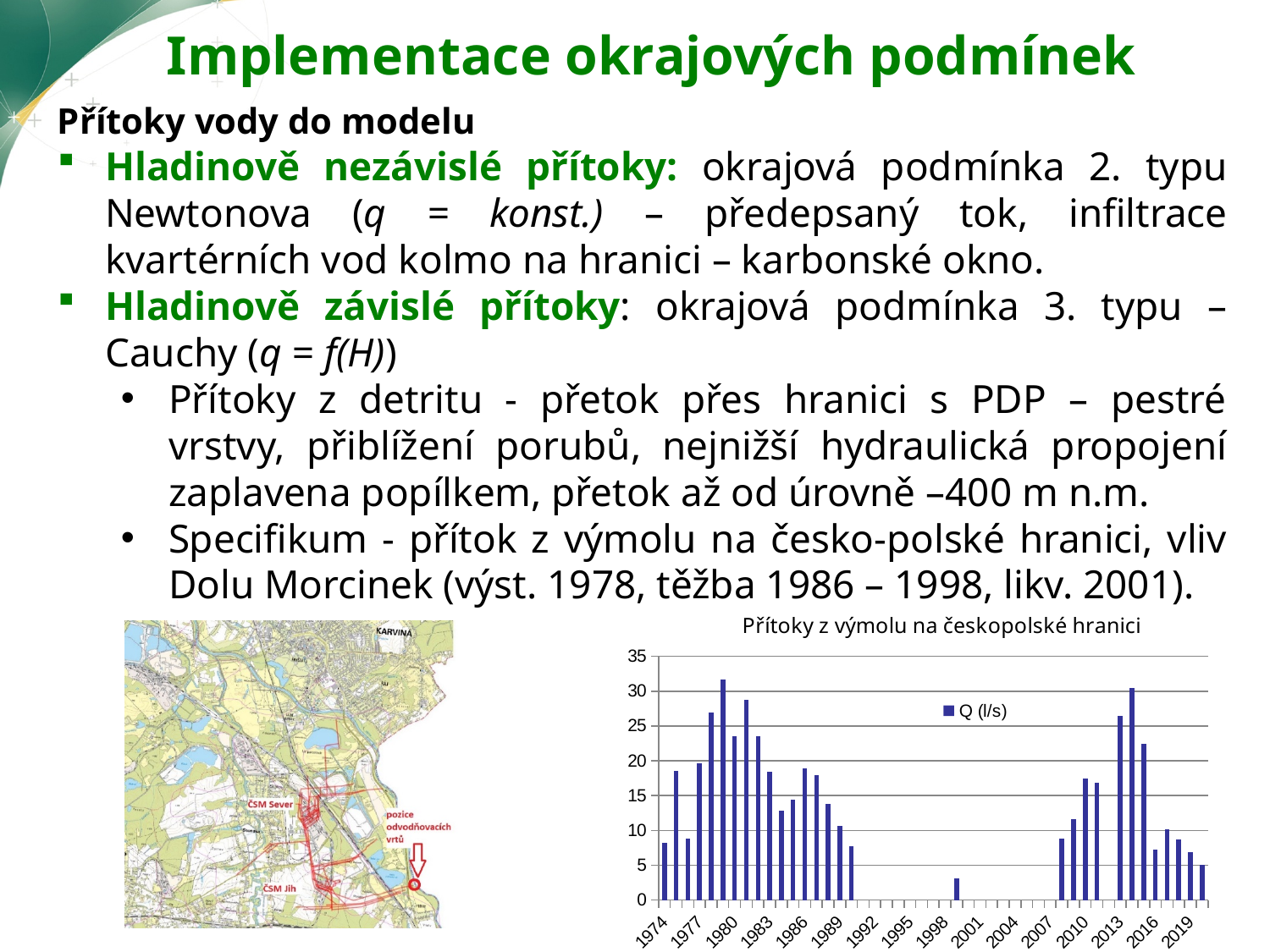
What is the legend entry of the chart 'Přítoky z výmolu na českopolské hranici'? Q (l/s) In the chart 'Přítoky z výmolu na českopolské hranici', which year has the larger value, 1974 or 1980? 1980 In the chart 'Přítoky z výmolu na českopolské hranici', is the value for 2016 greater or less than 10? less In the chart 'Přítoky z výmolu na českopolské hranici', do the values rise or fall from 1986 to 1989? fall In the chart 'Přítoky z výmolu na českopolské hranici', is the value for 1974 greater or less than 10? less In the chart 'Přítoky z výmolu na českopolské hranici', is the value for 2013 greater or less than 20? greater What kind of chart is 'Přítoky z výmolu na českopolské hranici'? bar chart How many series does the legend of the chart 'Přítoky z výmolu na českopolské hranici' list? 1 What is the highest value shown on the y axis of the chart 'Přítoky z výmolu na českopolské hranici'? 35